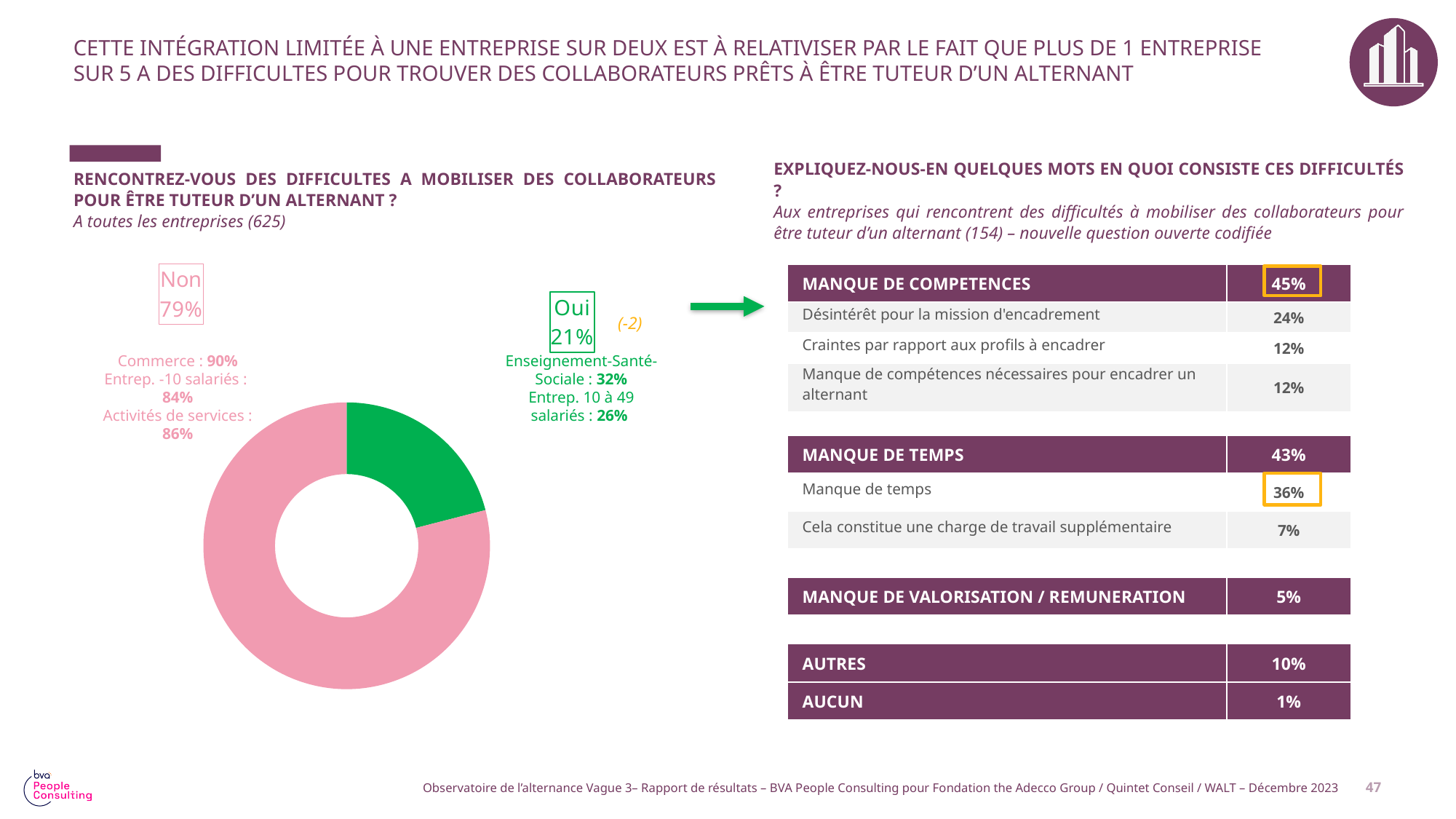
Which response has the largest slice in the donut chart? Non In the donut chart, what percentage of companies answered "Non"? 79% Which response has the smallest slice in the donut chart? Oui What share of the donut chart does the "Oui" slice represent? 21% What is the total of the two slices shown in the donut chart? 100% What colour is the "Oui" slice in the donut chart? Green In the donut chart, what percentage of companies answered "Oui"? 21% What type of chart is used to show the answers to the question about difficulties mobilising tutors? Donut (pie) chart By how many percentage points does "Non" exceed "Oui" in the donut chart? 58 percentage points How many slices does the donut chart have? 2 In the donut chart, which is larger: the "Oui" slice or the "Non" slice? Non What colour is the "Non" slice in the donut chart? Pink